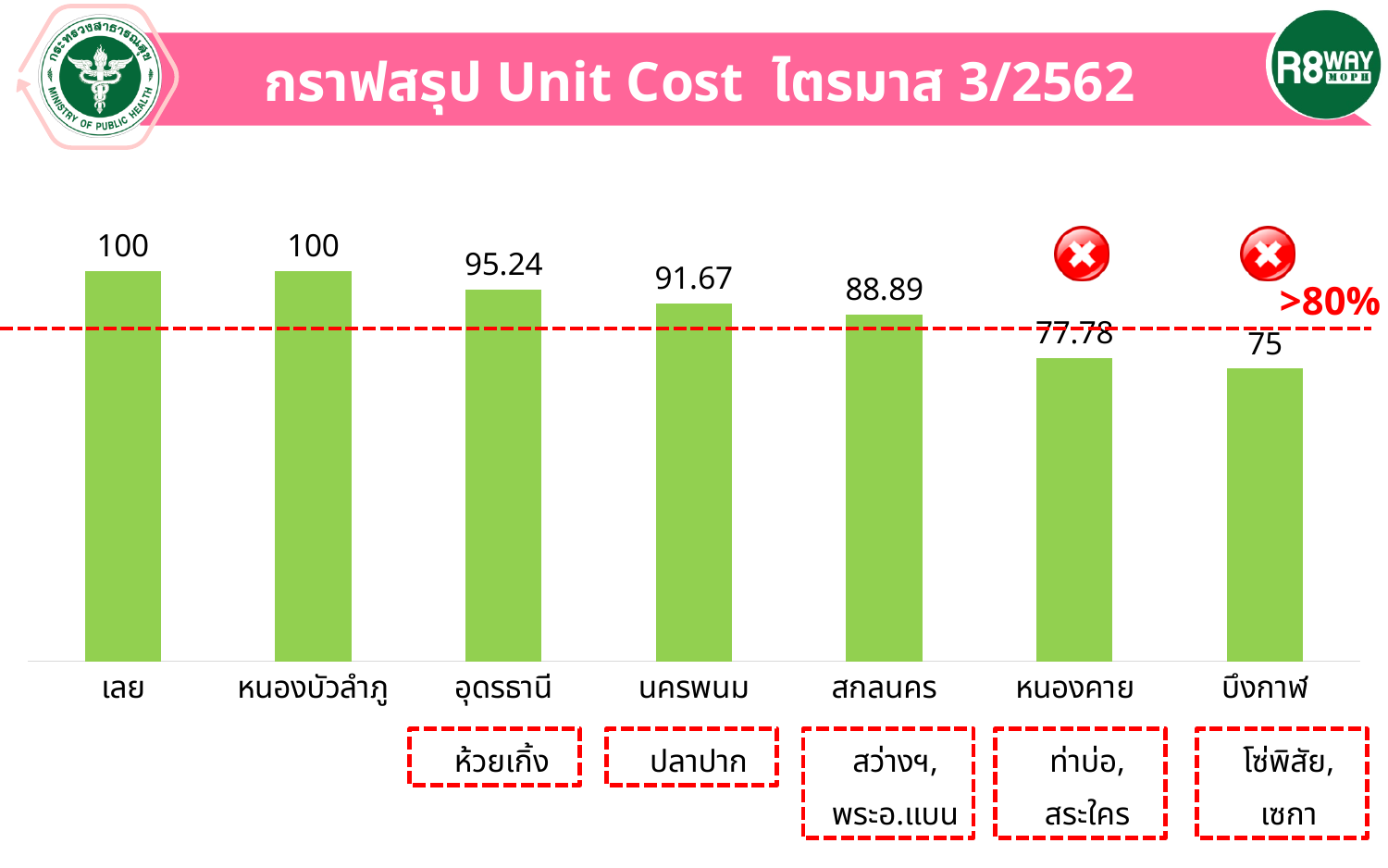
What kind of chart is shown on the slide? Bar chart What threshold is marked by the red dashed line on the chart? >80% Which is larger, the value for สกลนคร or the value for หนองคาย? สกลนคร What is the value for อุดรธานี? 95.24 What is the value for นครพนม? 91.67 Which category has the lowest value? บึงกาฬ What is the difference between the values for อุดรธานี and นครพนม? 3.57 Do the values rise or fall from left to right along the x axis? Fall What is the value for สกลนคร? 88.89 What is the difference between the values for เลย and บึงกาฬ? 25 What is the value for หนองคาย? 77.78 How many categories are shown in the chart? 7